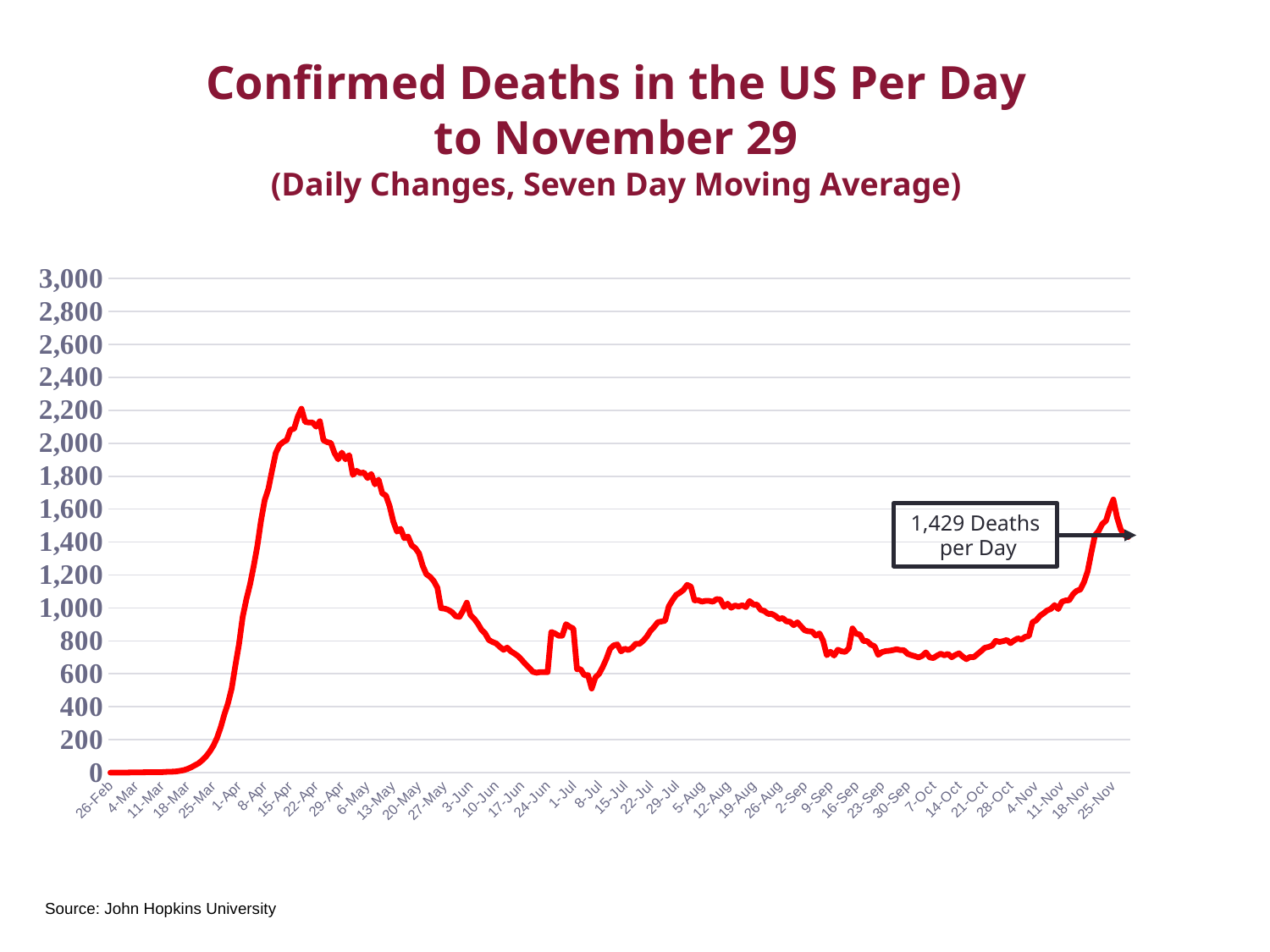
Is the value at 26-Feb greater or less than 200? less Does the line rise or fall between 22-Apr and 24-Jun? fall What kind of chart is shown on the slide? line chart Is the value around 7-Oct greater or less than 800? less Is the value around 22-Apr larger or smaller than the value around 25-Nov? larger Is the value around 5-Aug greater or less than 1,000? greater What source is cited for the chart data? John Hopkins University What is the highest value shown on the vertical axis? 3,000 What value does the annotation on the chart give for deaths per day at the end of the series? 1,429 Deaths per Day Does the line rise or fall between 21-Oct and 25-Nov? rise